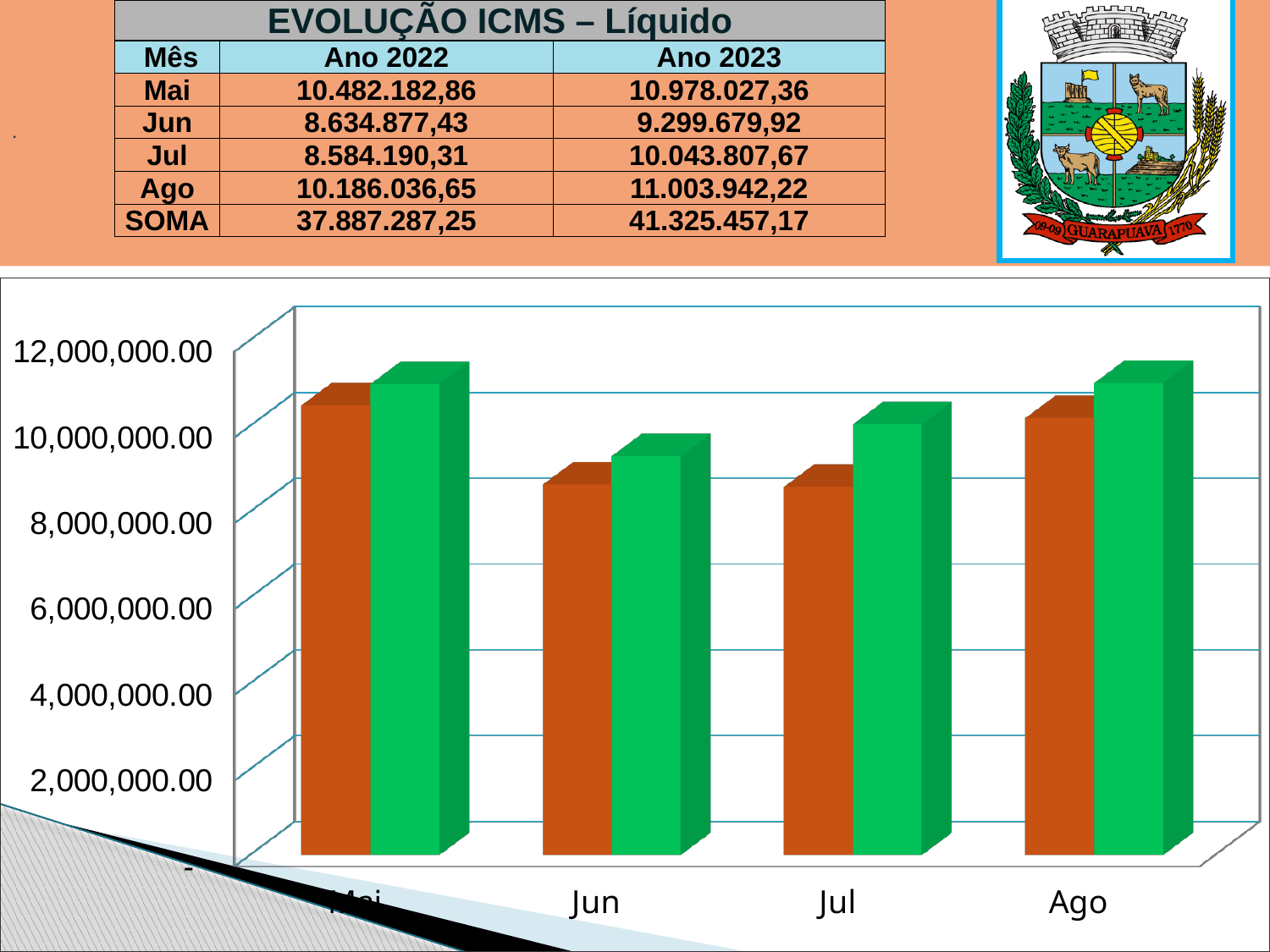
What kind of chart is shown on the slide? bar chart Is the green bar for Mai greater or less than 10,000,000.00? greater How many bars are plotted for each month in the chart? 2 Is the orange bar for Jun greater or less than 10,000,000.00? less Do the green bars rise or fall from Jun to Ago? rise According to the table above the chart, what is the difference between the SOMA for Ano 2023 and the SOMA for Ano 2022? 3.438.169,92 For Jul, which bar is taller, the orange one or the green one? the green one Is the green bar for Ago greater or less than 12,000,000.00? less How many months are shown on the x axis of the chart? 4 According to the table above the chart, what is the ICMS value for Jul in Ano 2023? 10.043.807,67 Which month has the shortest green bar? Jun